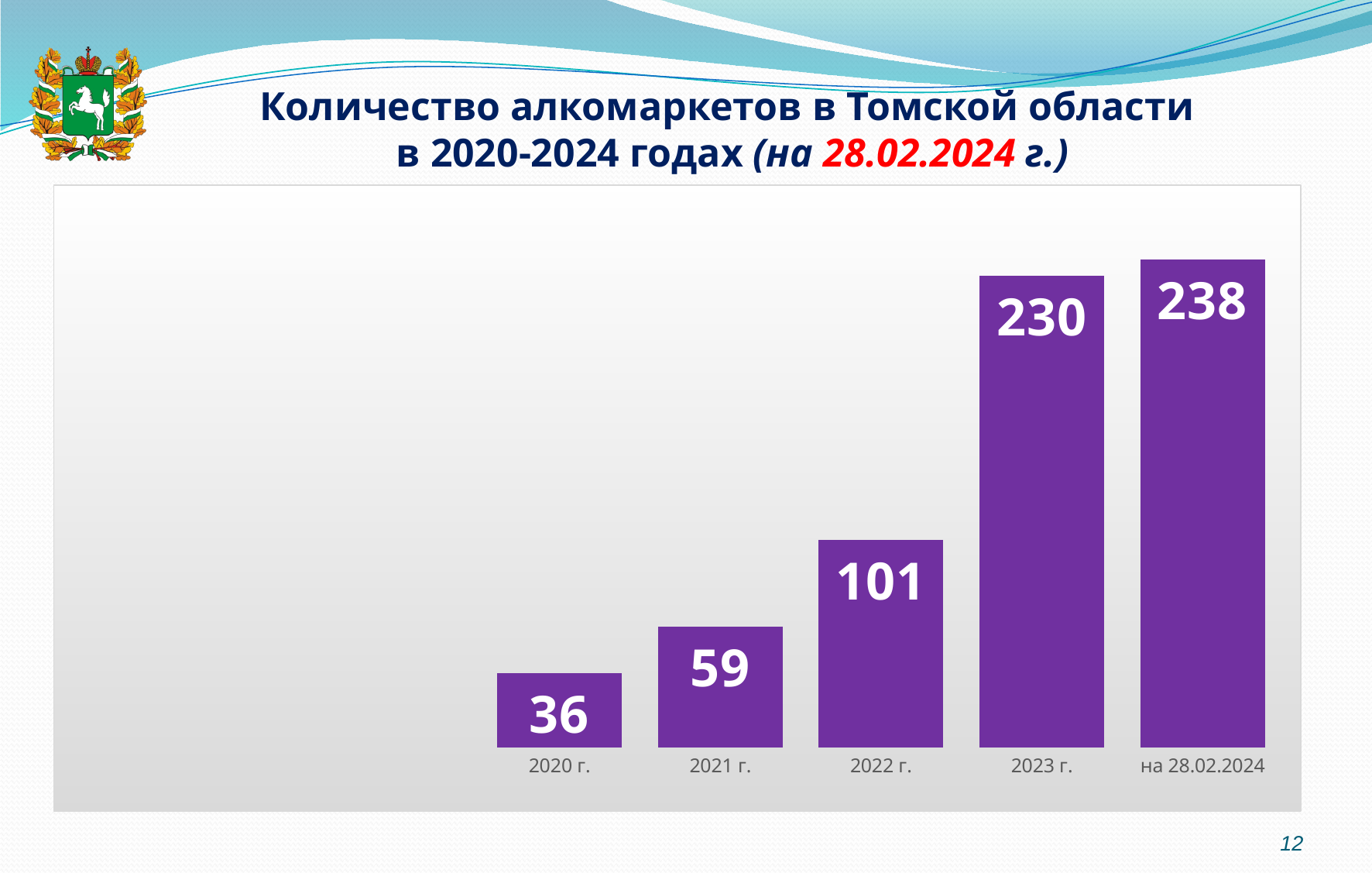
What value is shown for на 28.02.2024? 238 Which category has the highest value? на 28.02.2024 What kind of chart is shown on the slide? bar chart How many categories are shown on the x axis? 5 What is the number of alcohol markets shown for 2020 г.? 36 What value is shown for 2022 г.? 101 Which is larger, the value for 2021 г. or the value for 2022 г.? 2022 г. What is the difference between the values for 2021 г. and 2020 г.? 23 Which category has the lowest value? 2020 г. Do the values rise or fall from 2020 г. to на 28.02.2024? rise What colour are the bars in the chart? purple What is the difference between the values for 2023 г. and 2022 г.? 129